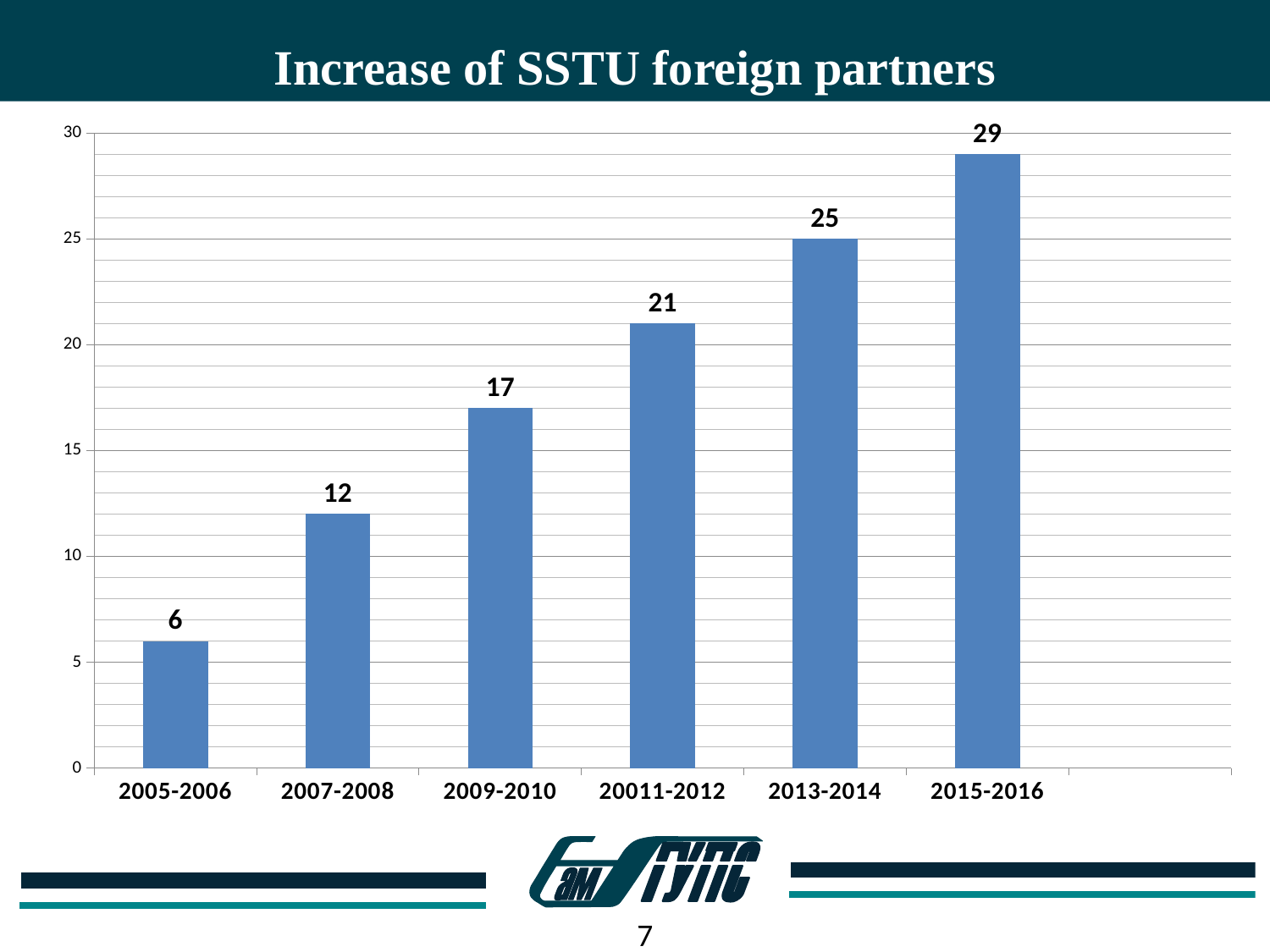
Which period has the highest value? 2015-2016 What kind of chart is shown on the slide? bar chart What is the difference between the values for 2015-2016 and 2005-2006? 23 Is the value for 2007-2008 greater or less than 10? greater What is the value for 2005-2006? 6 Which is larger, the value for 20011-2012 or the value for 2013-2014? 2013-2014 What is the value for 2009-2010? 17 Do the values rise or fall from 2005-2006 to 2015-2016? rise Which period has the lowest value? 2005-2006 How many periods are shown on the x axis? 6 What is the difference between the values for 2007-2008 and 2009-2010? 5 What is the value for 2013-2014? 25